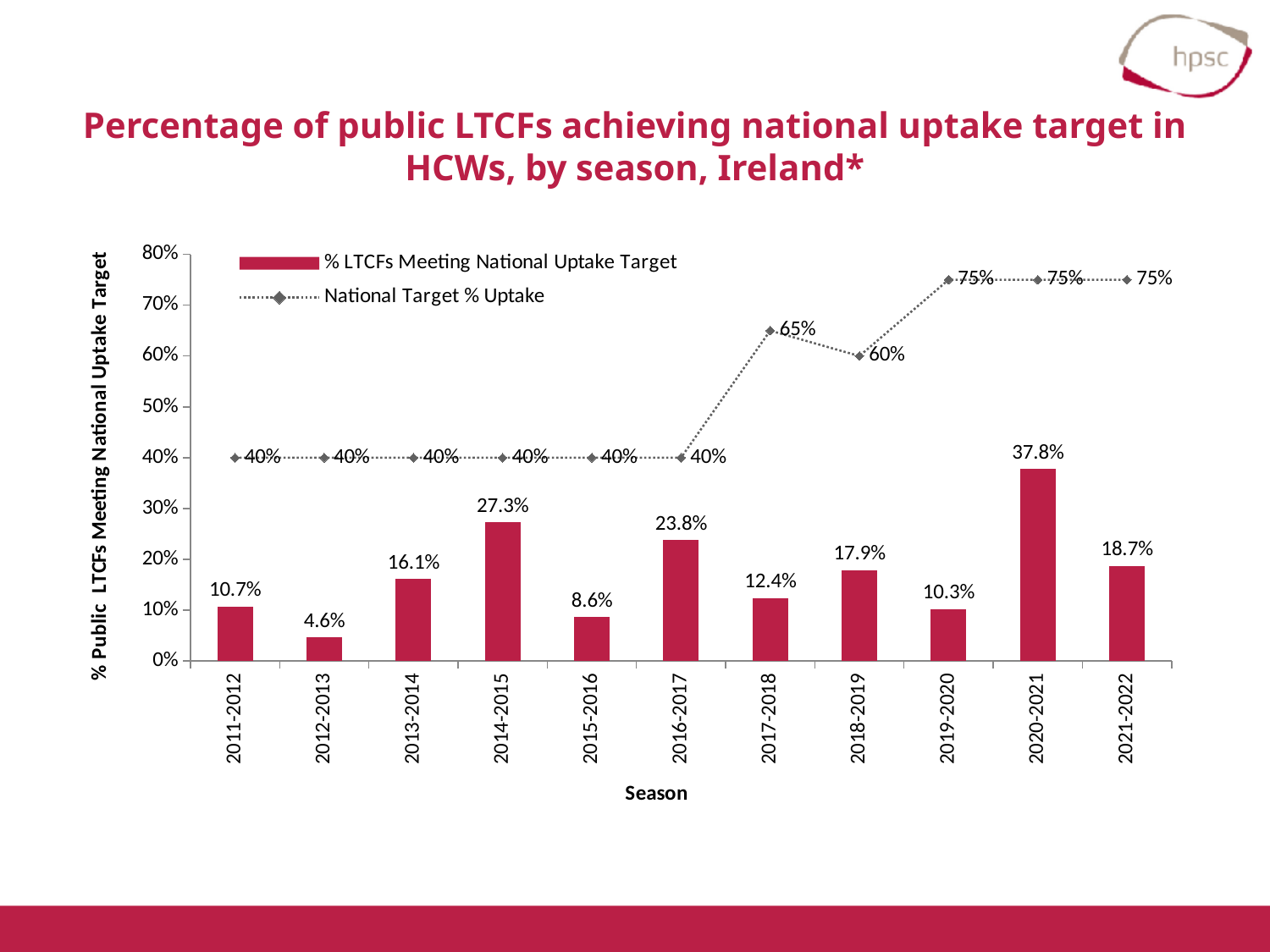
How many series does the legend list? 2 What is the label of the x axis? Season What was the National Target % Uptake for the 2017-2018 season? 65% How many seasons are shown on the x axis? 11 What percentage of public LTCFs met the national uptake target in 2012-2013? 4.6% What type of chart is used to show the % LTCFs Meeting National Uptake Target series? Bar chart Which season had the highest percentage of public LTCFs meeting the national uptake target? 2020-2021 What percentage of public LTCFs met the national uptake target in the 2020-2021 season? 37.8% Which season had a higher percentage of LTCFs meeting the target, 2014-2015 or 2016-2017? 2014-2015 What is the difference in the percentage of LTCFs meeting the target between 2020-2021 and 2021-2022? 19.1% What was the National Target % Uptake in the 2018-2019 season? 60% Which season had the lowest percentage of public LTCFs meeting the national uptake target? 2012-2013